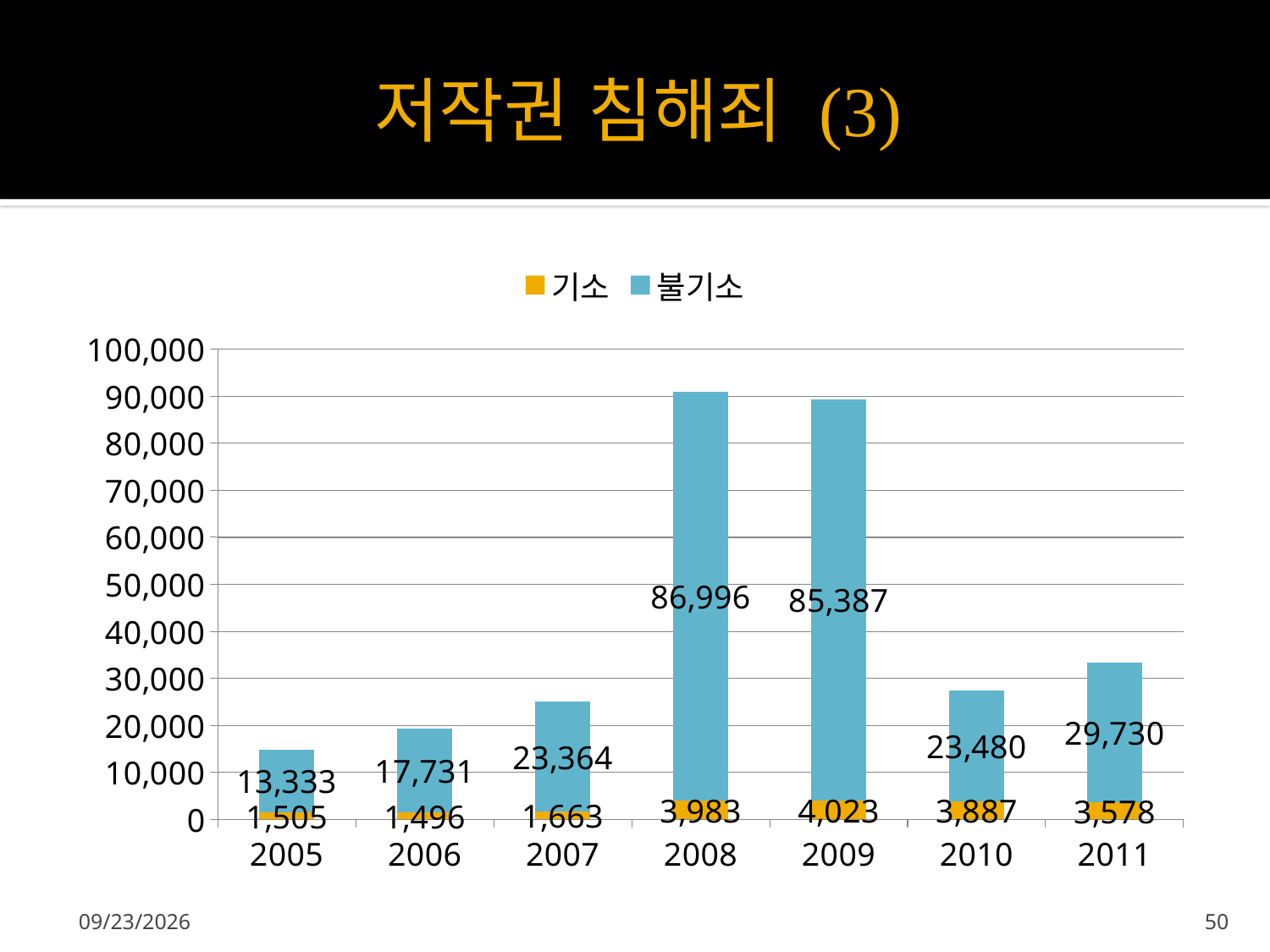
What is the difference between the 불기소 values for 2008 and 2009? 1,609 How many series does the legend list? 2 What is the 기소 value for 2011? 3,578 Which year has the lowest 불기소 value? 2005 How many years are shown on the x axis? 7 What is the total of the stacked bar for 2008? 90,979 What is the 불기소 value for 2006? 17,731 Which year has the highest 기소 value? 2009 Which is larger, the 불기소 value for 2010 or for 2011? 2011 What kind of chart is shown on the slide? Stacked bar chart What is the 불기소 value for 2008? 86,996 Which year has the highest 불기소 value? 2008